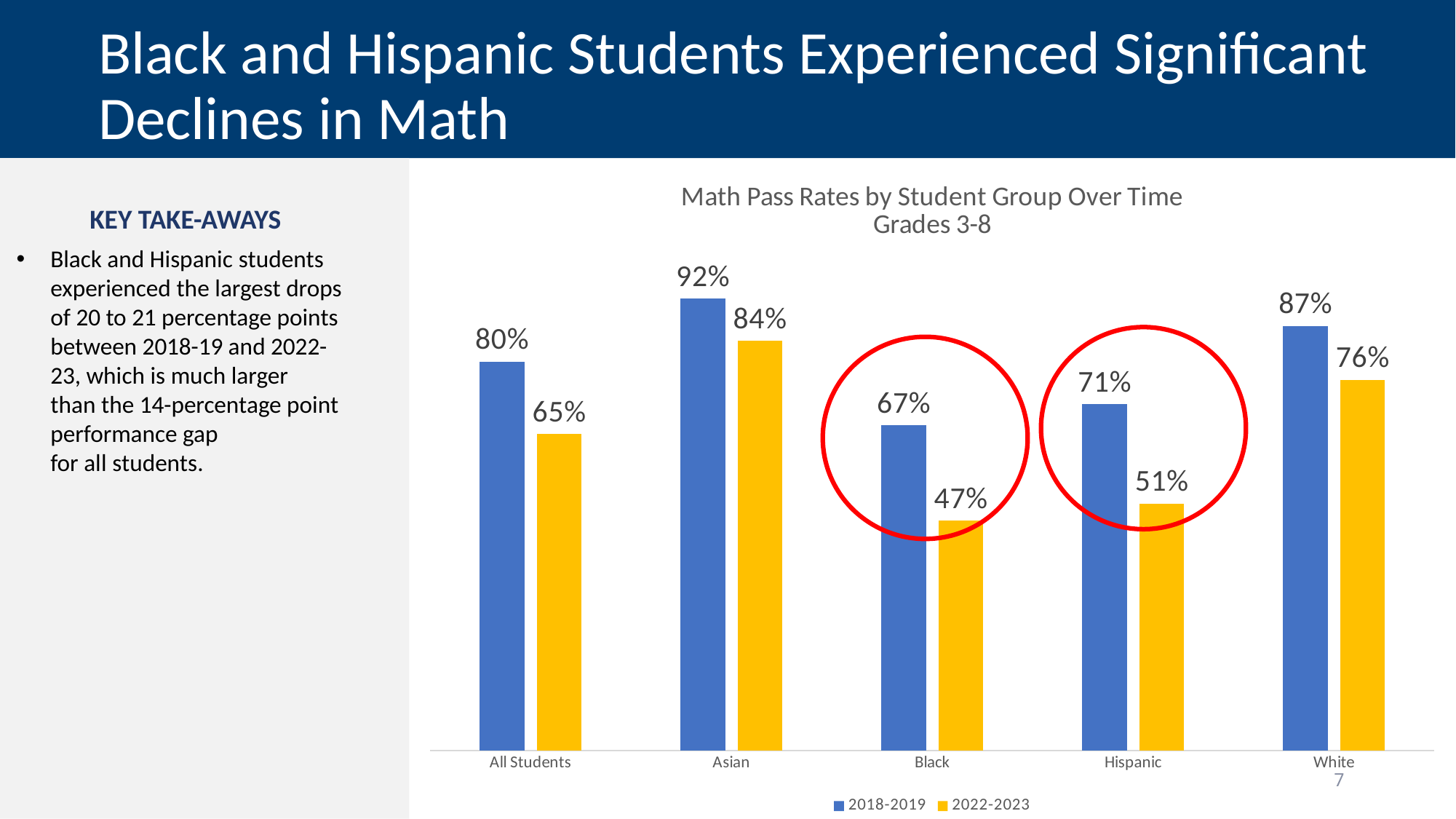
What kind of chart is shown on the slide? Bar chart What is the difference between the 2018-2019 and 2022-2023 math pass rates for White students? 11 percentage points Which student group had the highest math pass rate in 2018-2019? Asian What was the math pass rate for Hispanic students in 2022-2023? 51% Which colour represents the 2022-2023 series in the chart? Yellow What was the math pass rate for Black students in 2018-2019? 67% Which is larger: the 2022-2023 pass rate for Asian students or the 2018-2019 pass rate for White students? 2018-2019 pass rate for White students How many series does the chart legend list? 2 By how many percentage points did the math pass rate for Black students drop from 2018-2019 to 2022-2023? 20 How many student groups are shown on the x axis of the chart? 5 What was the math pass rate for All Students in 2022-2023? 65% Which student group had the lowest math pass rate in 2022-2023? Black